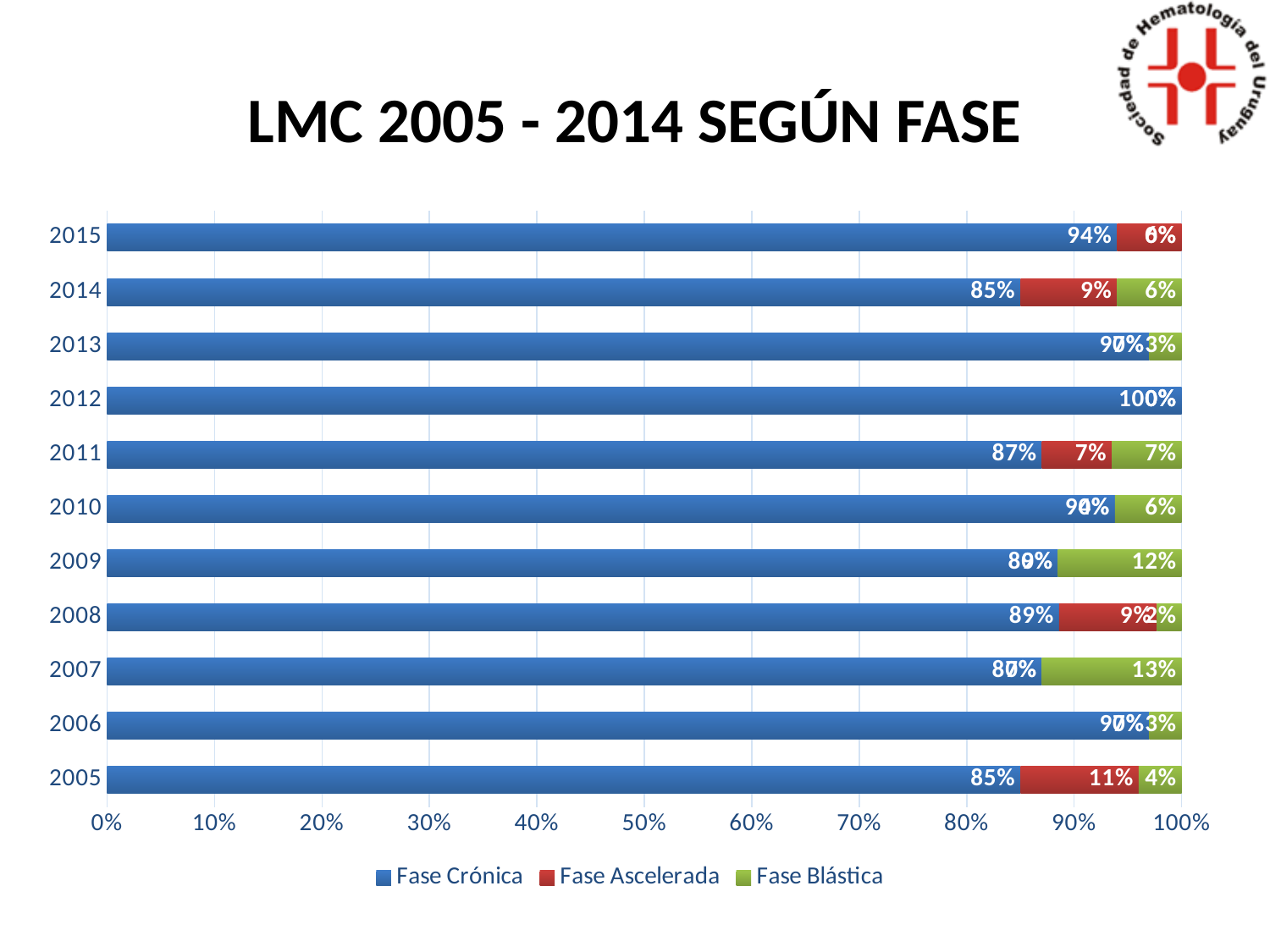
What type of chart is shown on the slide? Stacked bar chart What is the Fase Blástica value for 2011? 7% What is the difference between the Fase Ascelerada value for 2005 and for 2014? 2% What is the Fase Ascelerada value for 2005? 11% What is the Fase Crónica value for 2012? 100% What is the title of the chart? LMC 2005 - 2014 SEGÚN FASE How many series does the legend list? 3 Which is larger, the Fase Crónica value for 2011 or for 2014? 2011 How many years are shown on the chart? 11 Which year has the highest Fase Crónica value? 2012 What is the Fase Crónica value for 2014? 85% Is the Fase Crónica value for 2015 greater or less than 90%? greater